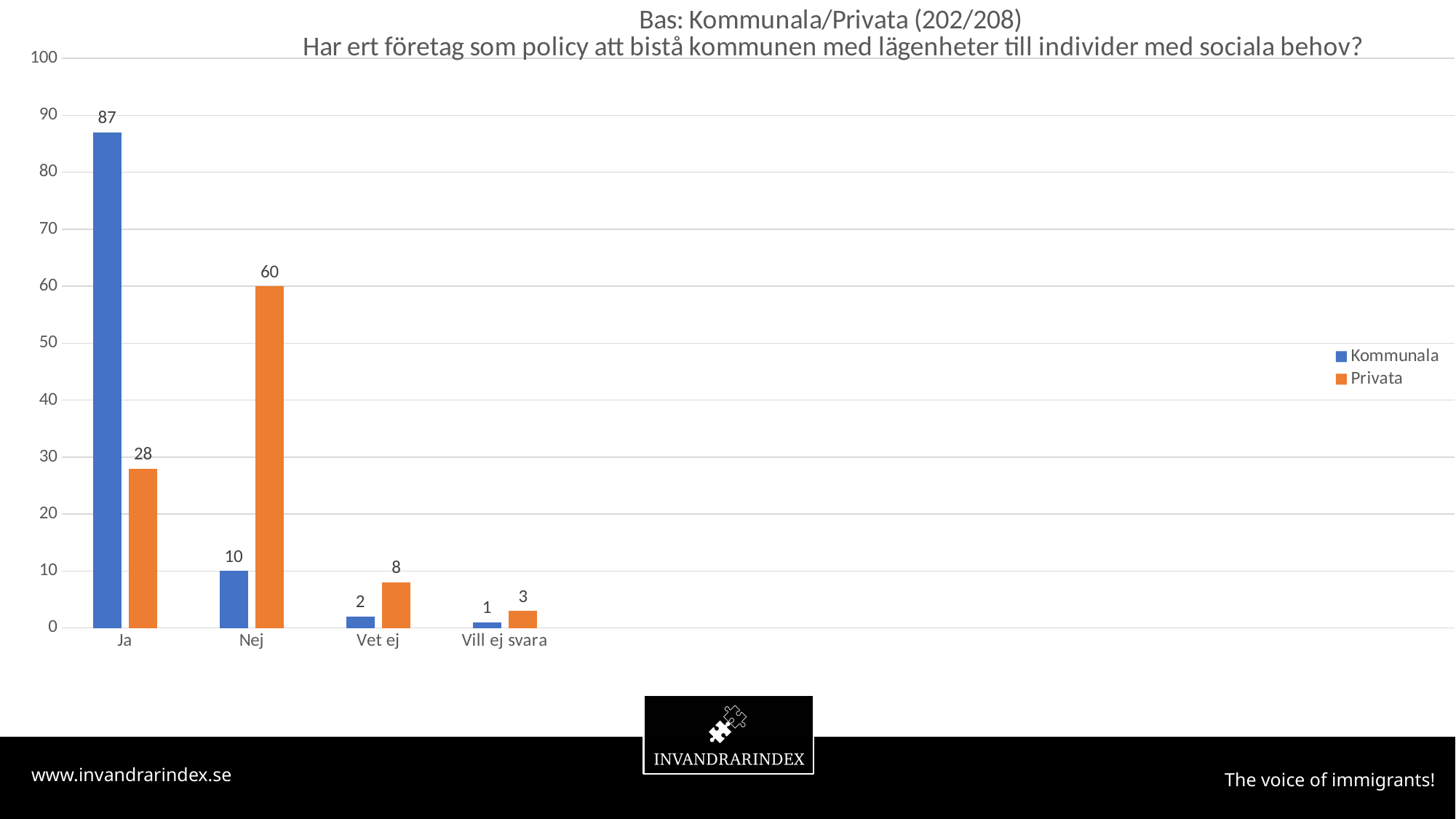
Which category has the lowest value for the Privata series? Vill ej svara How many categories are shown on the x axis? 4 What is the value for Privata in the Nej category? 60 How many series does the legend list? 2 What kind of chart is shown on the slide? Bar chart Which colour represents the Privata series in the legend? Orange What is the value for Privata in the Vet ej category? 8 What is the difference between the Kommunala and Privata values in the Ja category? 59 Which category has the highest value for the Kommunala series? Ja In the Nej category, which series has the larger value, Kommunala or Privata? Privata What is the difference between the Privata values for Nej and Ja? 32 What is the value for Kommunala in the Ja category? 87